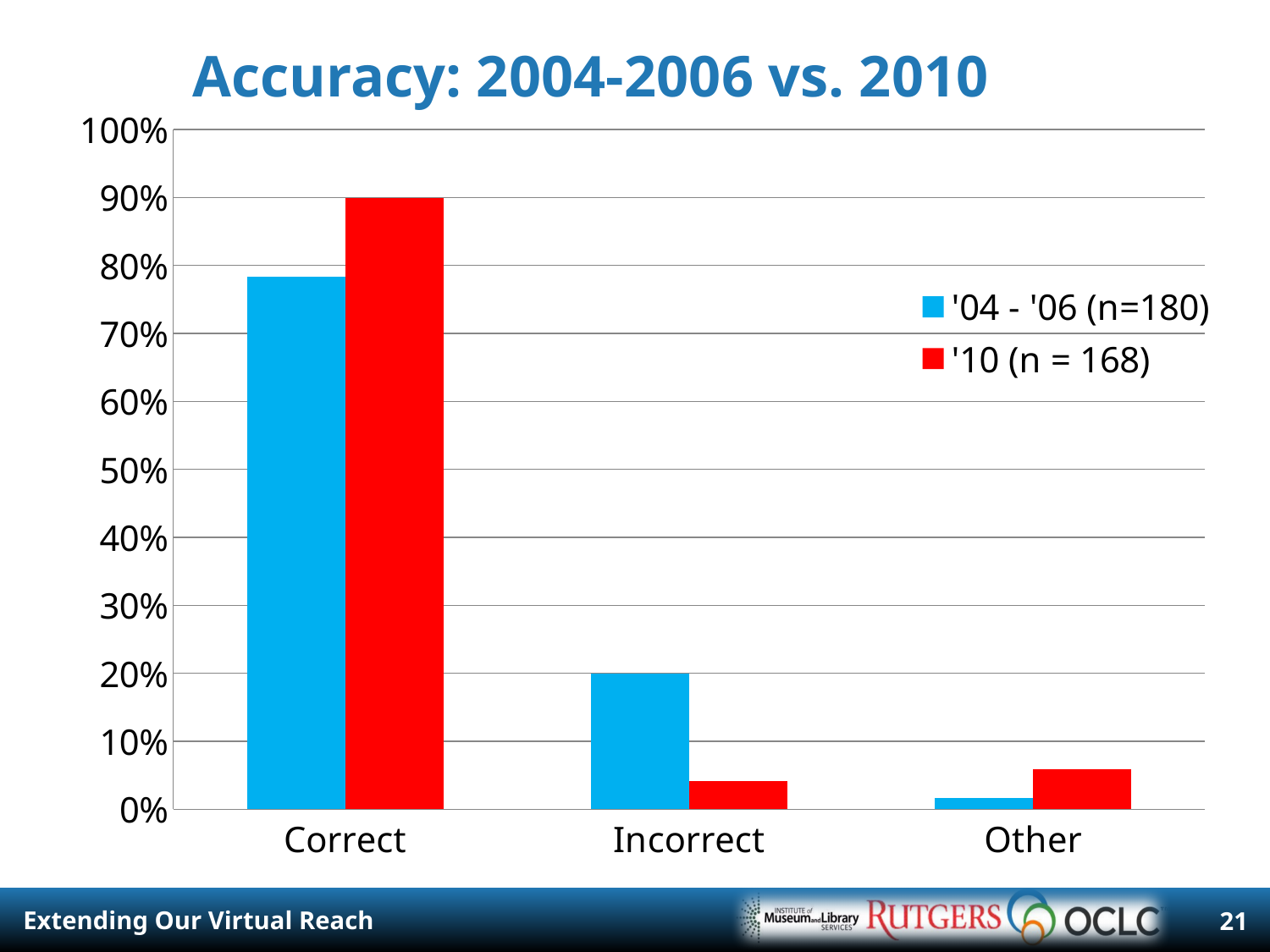
Which category has the lowest value for the '04 - '06 (n=180) series? Other Which category has the highest value for the '10 (n = 168) series? Correct For the Correct category, which series has the larger value, '04 - '06 (n=180) or '10 (n = 168)? '10 (n = 168) Is the value for Correct in the '04 - '06 (n=180) series greater or less than 70%? greater Which colour represents the '10 (n = 168) series in the legend? red What is the title of the chart? Accuracy: 2004-2006 vs. 2010 Is the value for Other in the '10 (n = 168) series greater or less than 10%? less Is the value for Incorrect in the '10 (n = 168) series greater or less than 10%? less How many categories are shown on the x axis? 3 For the Incorrect category, which series has the larger value, '04 - '06 (n=180) or '10 (n = 168)? '04 - '06 (n=180) How many series does the legend list? 2 What kind of chart is shown on the slide? bar chart